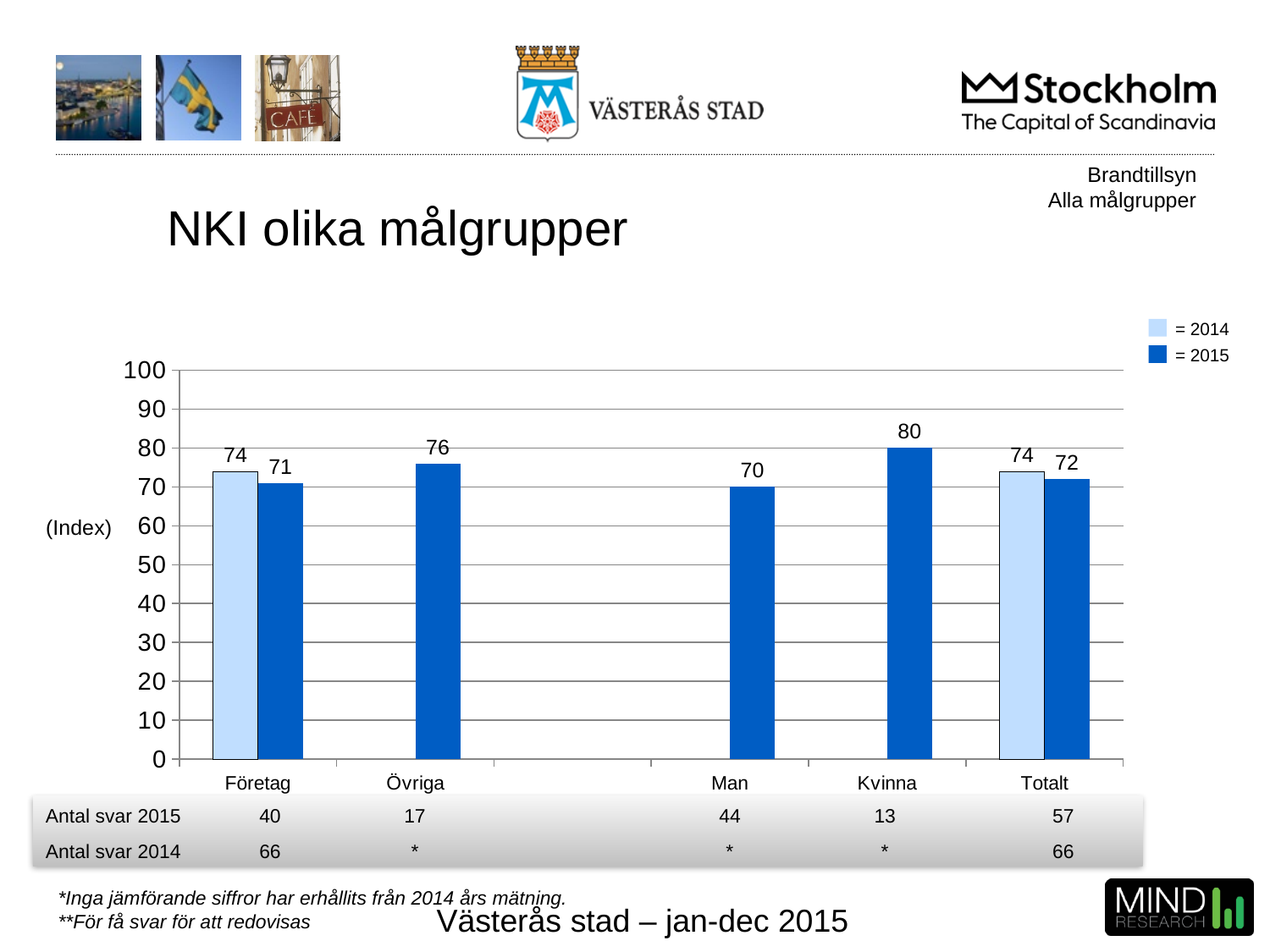
How many categories are shown on the x axis of the chart? 5 Which category has the lowest 2015 NKI value? Man Is the 2015 NKI value for Kvinna greater or less than 70? greater Which is larger, the 2015 NKI value for Övriga or for Man? Övriga What is the 2015 NKI value for Totalt? 72 What is the difference between the 2015 NKI values for Kvinna and Man? 10 What kind of chart is shown on the slide? bar chart What is the 2015 NKI value for Kvinna? 80 Which category has the highest 2015 NKI value? Kvinna By how much did the NKI value for Företag change from 2014 to 2015? 3 What is the 2014 NKI value for Företag? 74 How many series does the legend list? 2